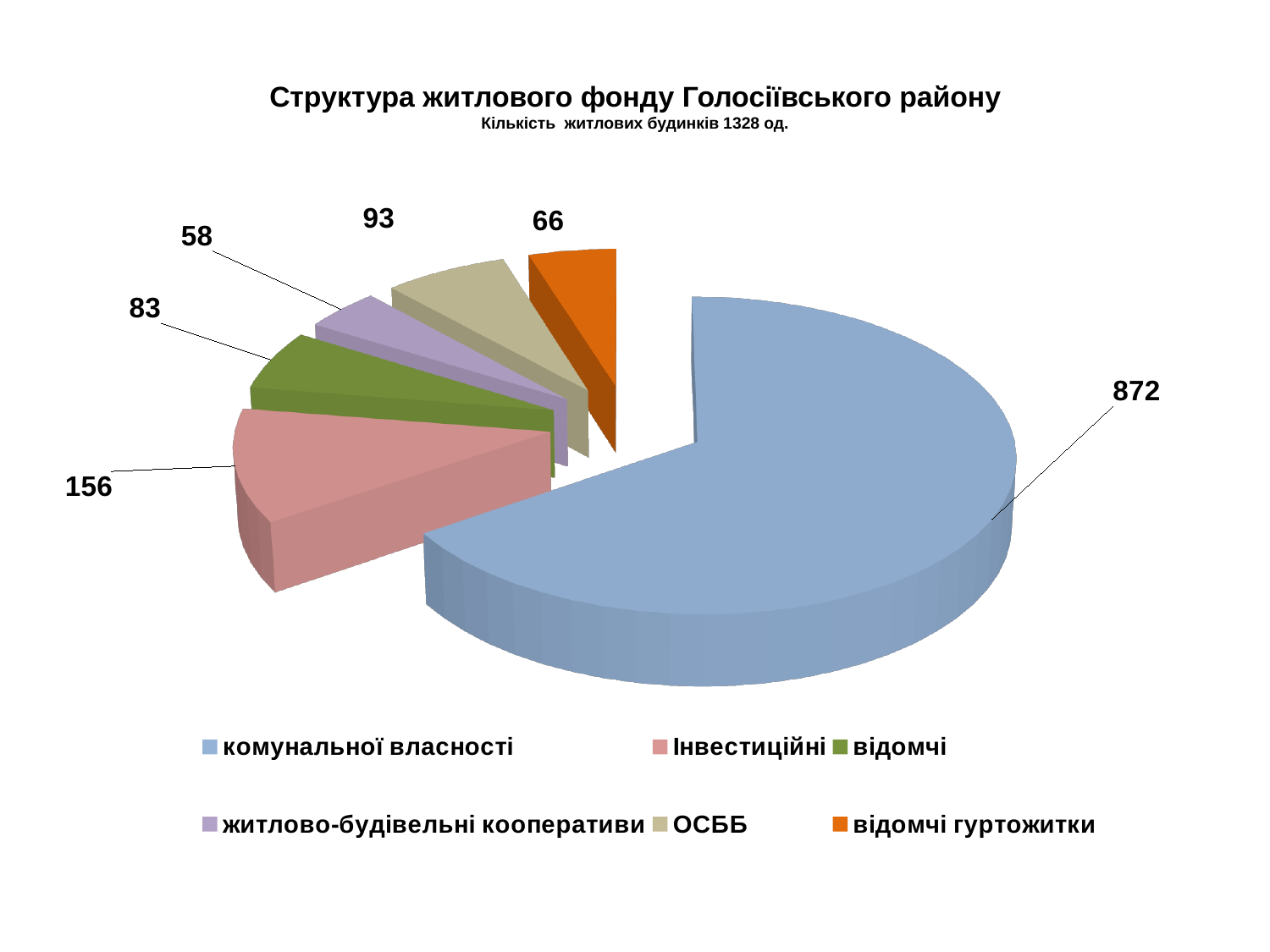
What kind of chart is shown on the slide? pie chart What is the value for комунальної власності? 872 How many categories does the pie chart show? 6 What is the difference between комунальної власності and Інвестиційні? 716 Which is larger, ОСББ or відомчі гуртожитки? ОСББ Which category has the smallest slice? житлово-будівельні кооперативи What is the value for ОСББ? 93 What is the value for Інвестиційні? 156 What is the difference between ОСББ and відомчі? 10 What total number of residential buildings is stated in the chart subtitle? 1328 од. Which category has the largest slice? комунальної власності What is the value for відомчі гуртожитки? 66